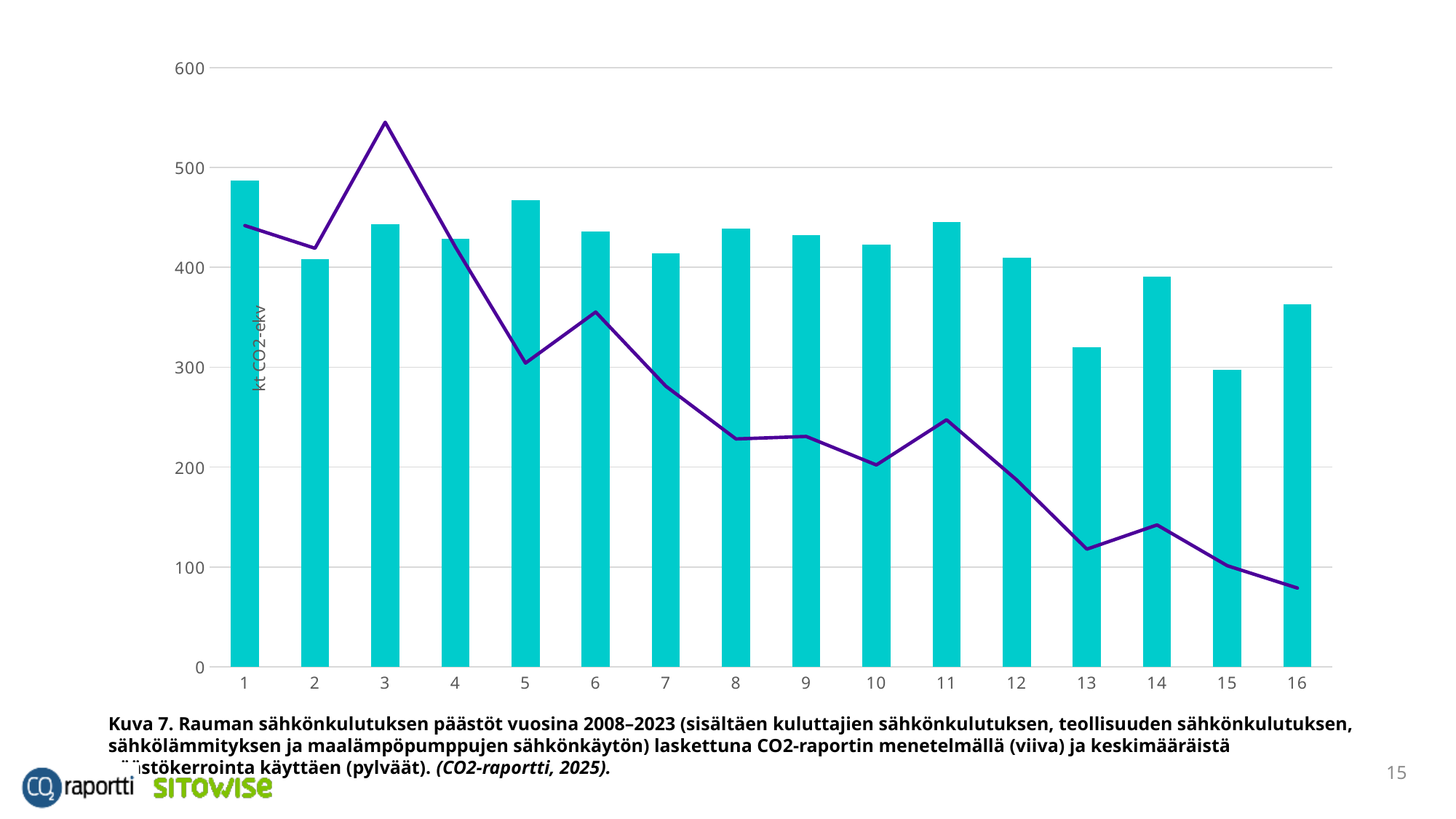
Is the line value at category 16 greater or less than 100? less How many categories are shown along the x axis? 16 What is the label on the y axis? kt CO2-ekv Is the bar value for category 1 greater or less than 400? greater Is the line value at category 3 greater or less than 500? greater Does the line generally rise or fall from category 1 to category 16? Fall At which category does the line reach its lowest point? 16 Which category has the tallest bar? 1 Which category has the shortest bar? 15 Which is larger, the bar for category 13 or the bar for category 14? Category 14 At which category does the line reach its highest point? 3 What kind of chart is shown on the slide? A combined bar and line chart